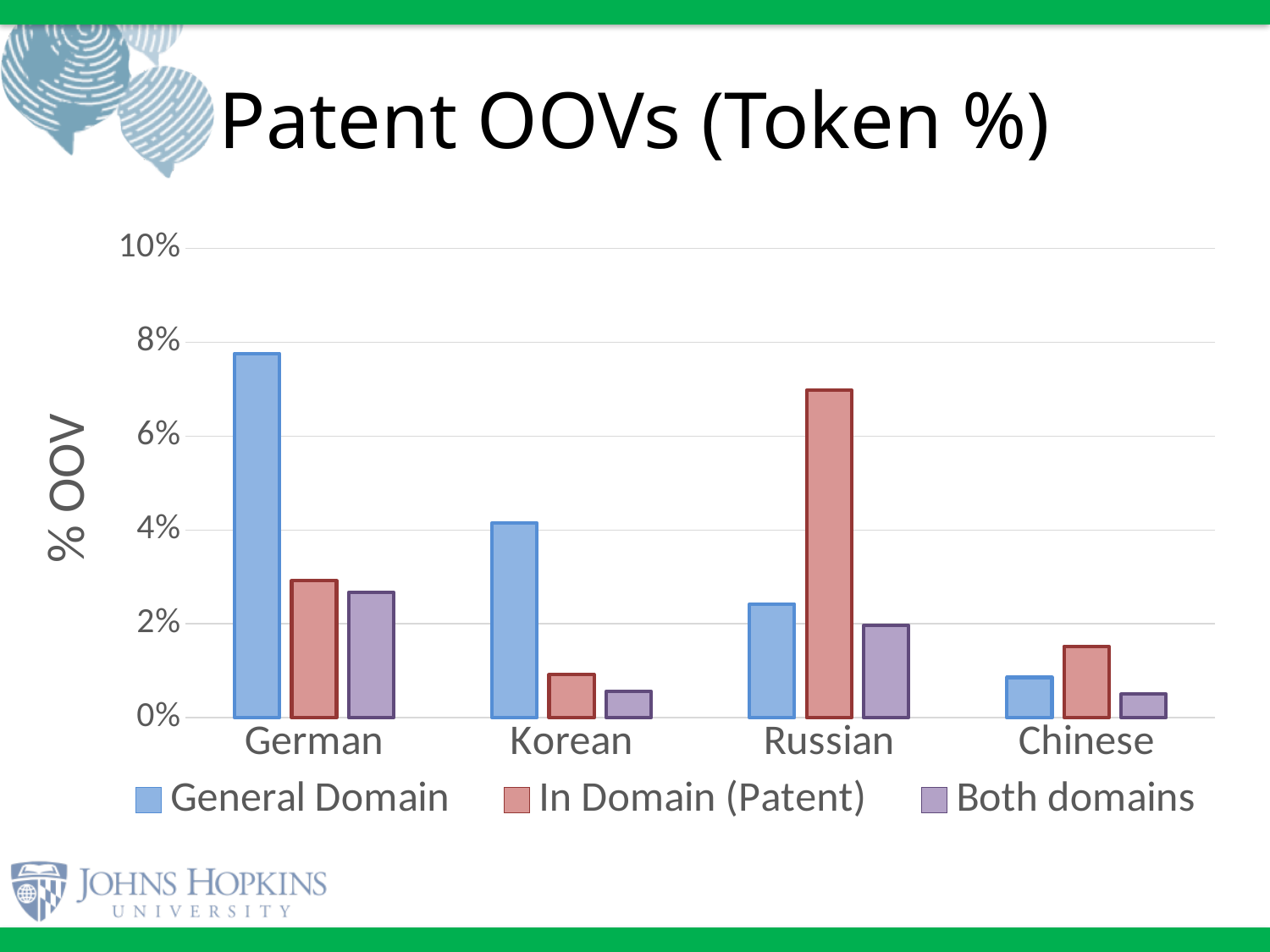
What kind of chart is shown on the slide? bar chart Is the In Domain (Patent) value for Korean greater or less than 2%? less Which language has the highest General Domain OOV rate? German Which language has the lowest General Domain OOV rate? Chinese For Russian, which is larger: the General Domain value or the In Domain (Patent) value? In Domain (Patent) Which language has the highest In Domain (Patent) OOV rate? Russian What is the title of the chart? Patent OOVs (Token %) How many series does the legend list? 3 How many language categories are shown on the x axis? 4 For Chinese, which is larger: the General Domain value or the In Domain (Patent) value? In Domain (Patent) Is the General Domain value for German greater or less than 6%? greater